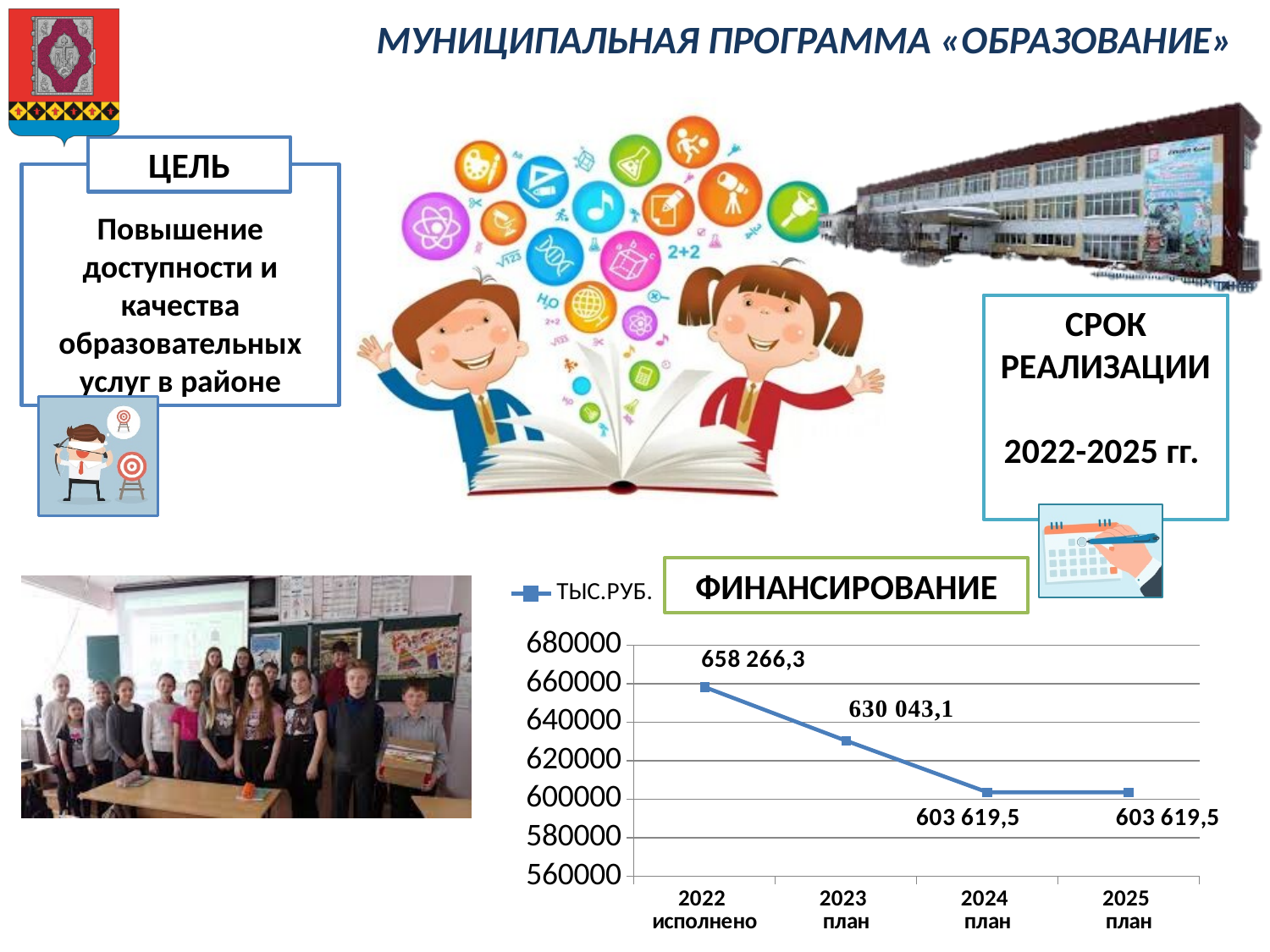
Which category has the highest value on the ФИНАНСИРОВАНИЕ chart? 2022 исполнено What is the value for 2025 план on the ФИНАНСИРОВАНИЕ chart? 603 619,5 Is the value for 2023 план on the ФИНАНСИРОВАНИЕ chart greater or less than 620000? greater Which is larger on the ФИНАНСИРОВАНИЕ chart: the value for 2022 исполнено or 2023 план? 2022 исполнено What is the value for 2024 план on the ФИНАНСИРОВАНИЕ chart? 603 619,5 What is the value for 2023 план on the ФИНАНСИРОВАНИЕ chart? 630 043,1 What kind of chart is the ФИНАНСИРОВАНИЕ chart? line chart Do the values on the ФИНАНСИРОВАНИЕ chart rise or fall from 2022 to 2024? fall What is the difference between the values for 2023 план and 2024 план on the ФИНАНСИРОВАНИЕ chart? 26 423,6 What is the value for 2022 исполнено on the ФИНАНСИРОВАНИЕ chart? 658 266,3 How many data points are plotted on the ФИНАНСИРОВАНИЕ chart? 4 What is the difference between the values for 2022 исполнено and 2023 план on the ФИНАНСИРОВАНИЕ chart? 28 223,2